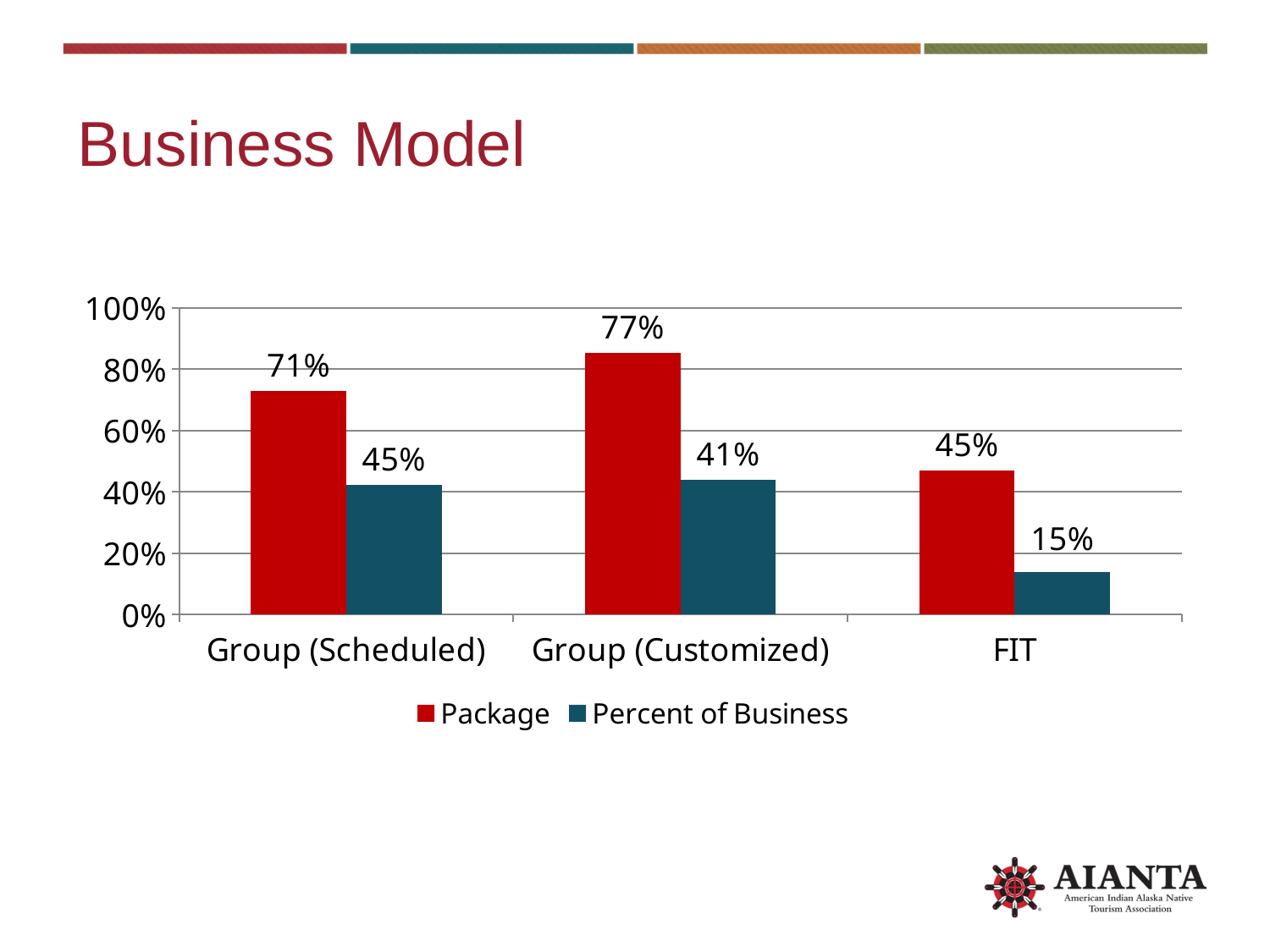
What kind of chart is shown on the slide? Bar chart Which is larger for FIT: the Package value or the Percent of Business value? Package What is the Percent of Business value for FIT? 15% Which category has the lowest Percent of Business value? FIT What is the Package value for Group (Customized)? 77% Which category has the highest Package value? Group (Customized) What is the difference between the Package value and the Percent of Business value for Group (Scheduled)? 26% What is the Percent of Business value for Group (Customized)? 41% What is the title of the slide containing the chart? Business Model How many categories are shown on the x axis? 3 What is the Package value for Group (Scheduled)? 71% How many series does the legend list? 2